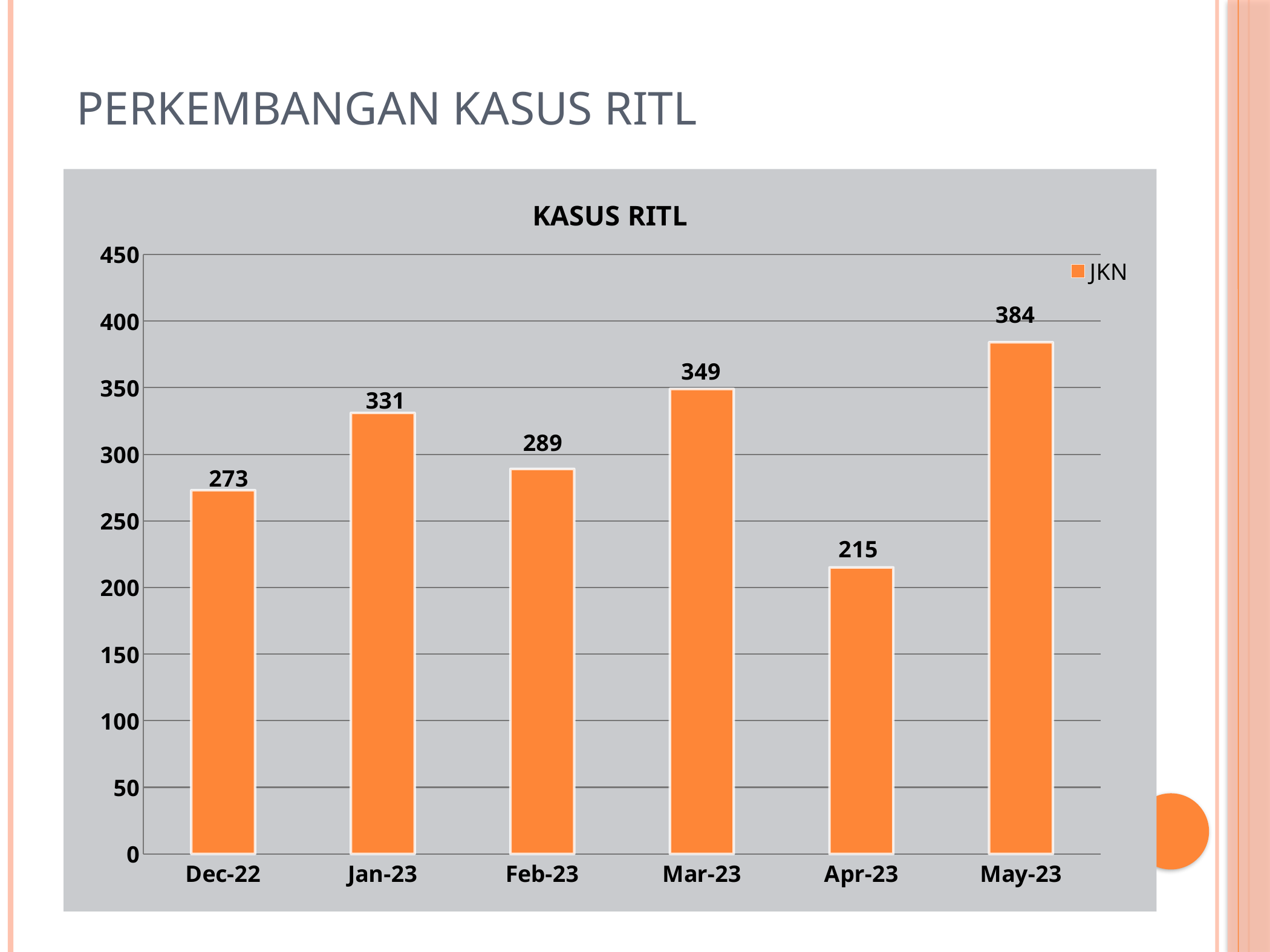
Which month has the highest value? May-23 What is the value for Apr-23? 215 What is the difference between the values for May-23 and Apr-23? 169 How many months are shown on the x axis? 6 What kind of chart is shown? bar chart Which is larger, the value for Jan-23 or the value for Mar-23? Mar-23 What series name does the legend show? JKN What is the value for Dec-22? 273 Is the value for Feb-23 greater or less than 300? less What is the value for Mar-23? 349 What is the difference between the values for Jan-23 and Feb-23? 42 Which month has the lowest value? Apr-23